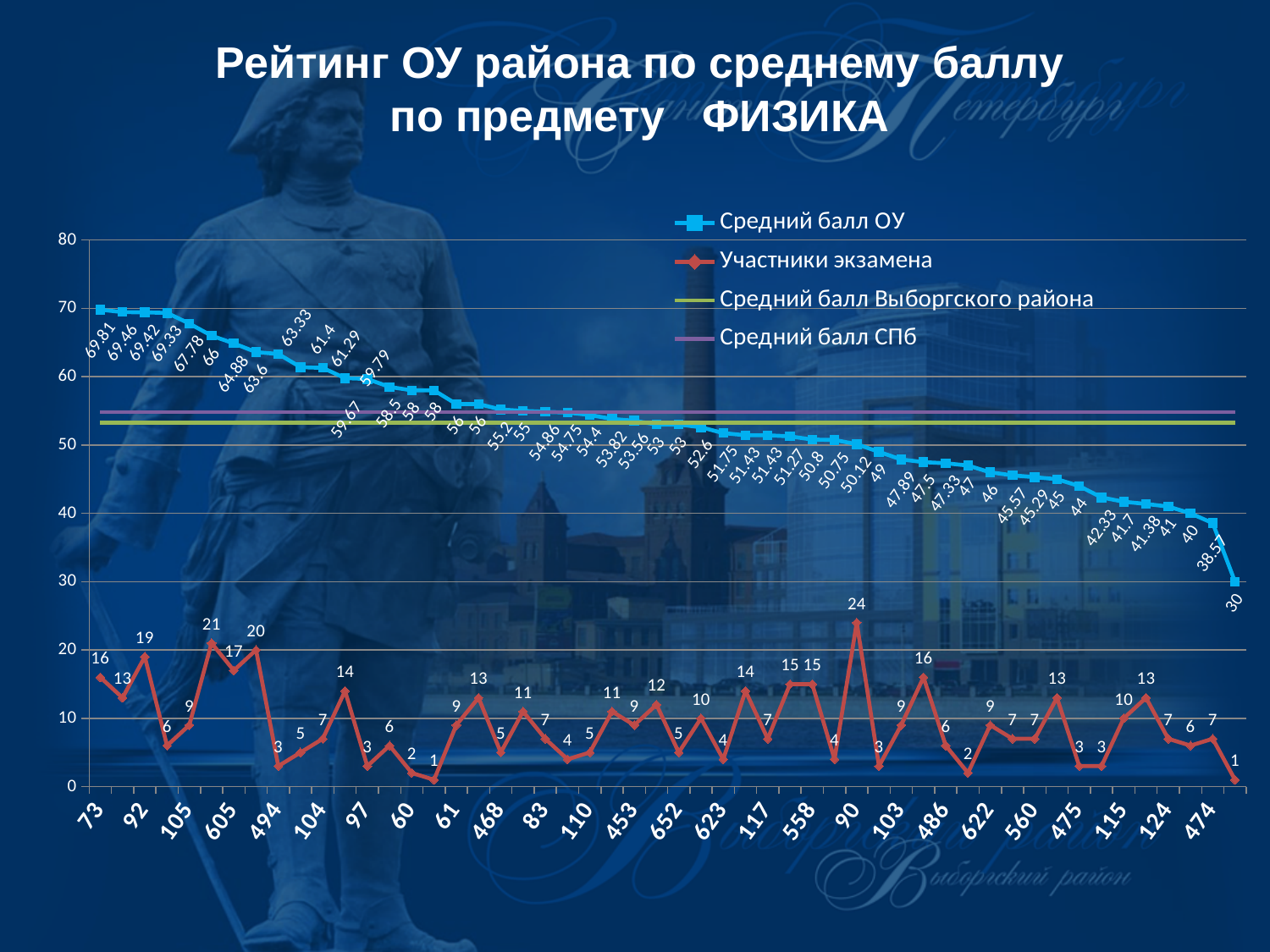
What is the highest value of the Средний балл ОУ series? 69.81 What is the value of Средний балл ОУ for category 73? 69.81 Do the values of Средний балл ОУ rise or fall along the x axis? fall Which subject is named in the chart title? ФИЗИКА How many series does the legend list? 4 Is the Средний балл Выборгского района line greater or less than 60? less What is the difference between the highest and lowest values of Средний балл ОУ? 39.81 What kind of chart is shown on the slide? line chart What is the lowest value of the Средний балл ОУ series? 30 What is the highest value of the Участники экзамена series? 24 Which line is higher, Средний балл СПб or Средний балл Выборгского района? Средний балл СПб What is the value of Участники экзамена for category 73? 16